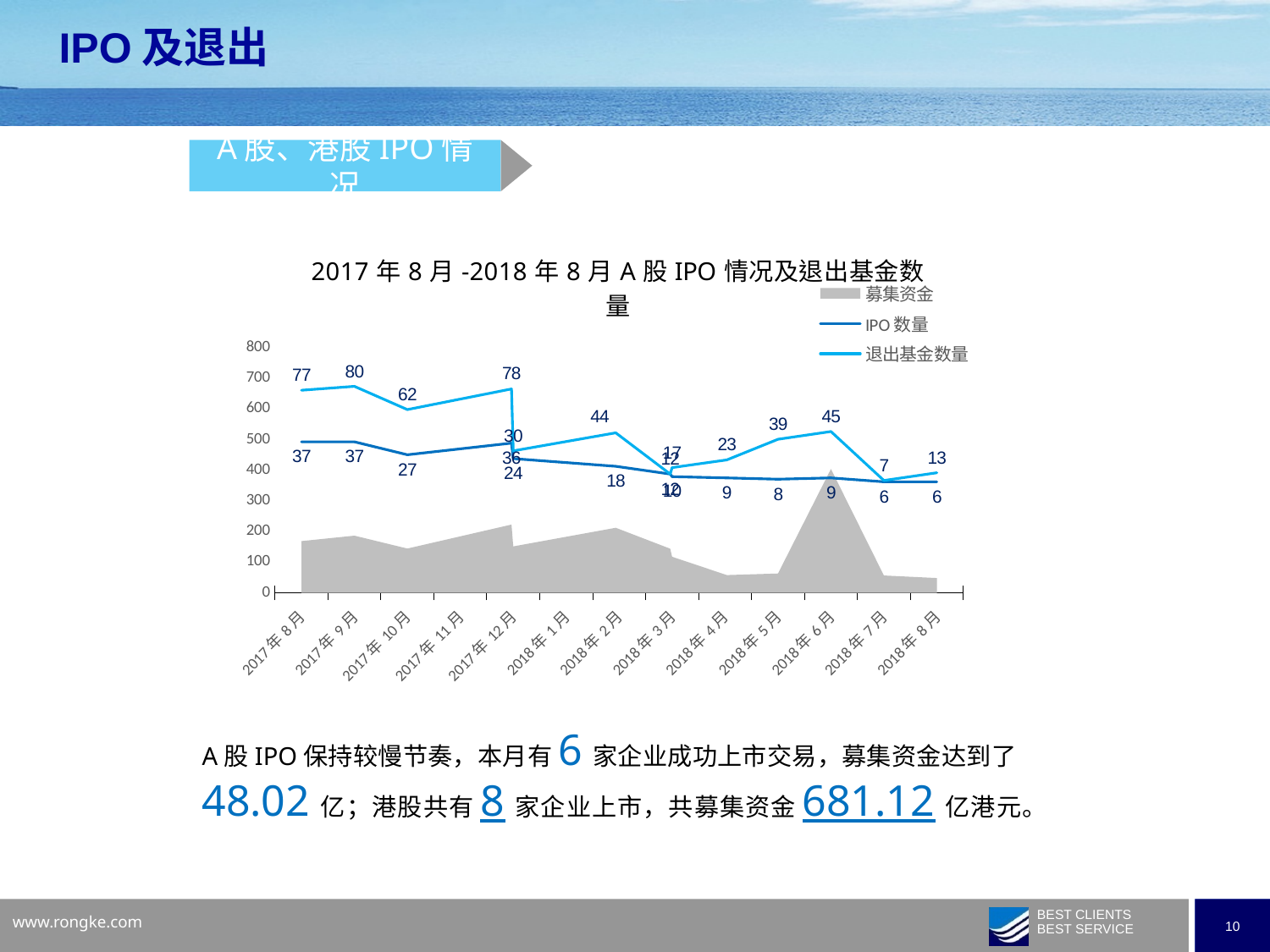
How many months are shown on the x axis of the chart? 13 In which month is the 退出基金数量 highest? 2017年9月 Does the IPO数量 series generally rise or fall from 2017年8月 to 2018年8月? fall How many series does the chart legend list? 3 What is the 退出基金数量 value for 2018年6月? 45 What is the title of the chart? 2017年8月-2018年8月A股IPO情况及退出基金数量 What is the 退出基金数量 value for 2017年9月? 80 What is the IPO数量 value for 2017年10月? 27 Is the 募集资金 value for 2018年6月 greater or less than 300? greater What is the difference between the 退出基金数量 values for 2018年6月 and 2018年5月? 6 In which month is the 退出基金数量 lowest? 2018年7月